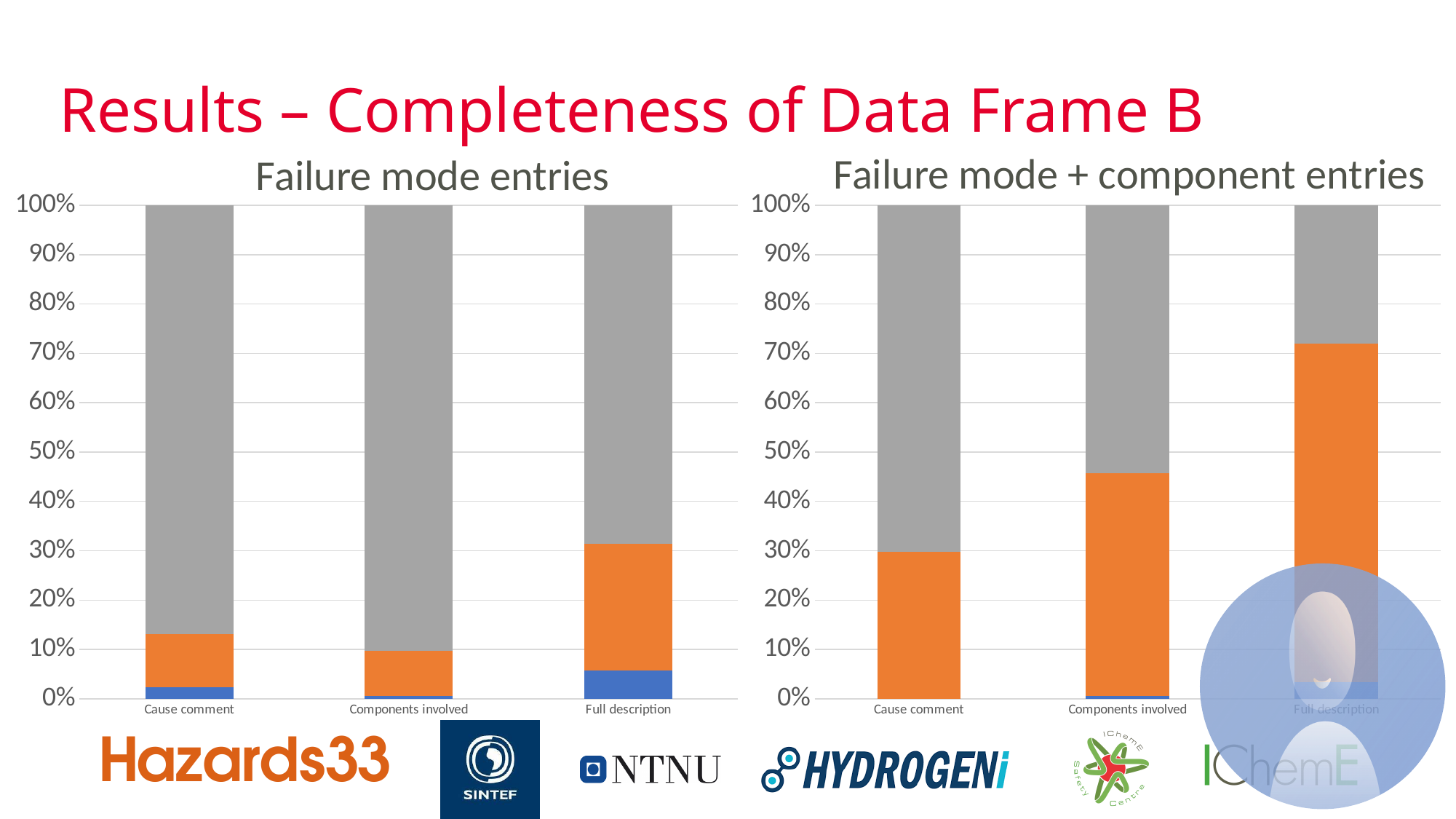
In the "Failure mode + component entries" chart, is the top of the orange segment for Cause comment greater or less than 40%? less In the "Failure mode + component entries" chart, is the top of the orange segment for Full description greater or less than 60%? greater In the "Failure mode entries" chart, is the top of the orange segment for Components involved greater or less than 20%? less In the "Failure mode entries" chart, which has the larger orange segment: Cause comment or Full description? Full description What is the title of the chart on the right side of the slide? Failure mode + component entries How many categories are shown on the x axis of the "Failure mode + component entries" chart? 3 In the "Failure mode + component entries" chart, which category has the largest orange segment? Full description In the "Failure mode entries" chart, which category has the largest orange segment? Full description In the "Failure mode + component entries" chart, which category has the smallest orange segment? Cause comment What type of chart is the "Failure mode entries" chart? Stacked bar chart